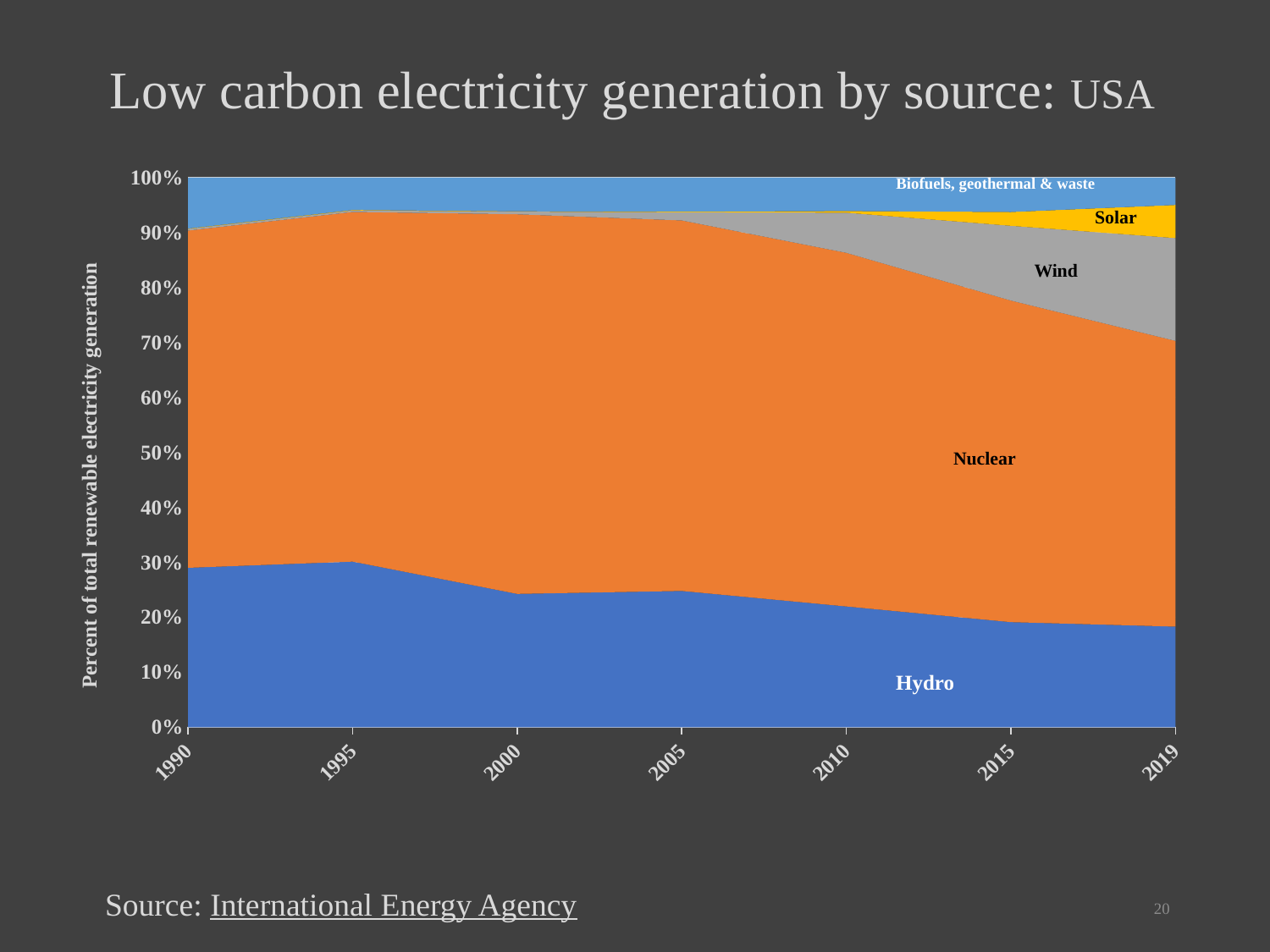
Does the share of Wind rise or fall from 2005 to 2019? Rise How many sources (series) are labelled in the chart? 5 How many years are labelled on the x axis? 7 Which source accounts for the largest share of low carbon electricity generation across the whole period? Nuclear Does the share of Hydro rise or fall from 1990 to 2019? Fall What kind of chart is shown on the slide? Stacked area chart Is the share of Hydro in 2019 greater or less than 25%? less Is the share of Hydro in 1990 greater or less than 20%? greater What is the label on the y axis? Percent of total renewable electricity generation In 2019, which has the larger share: Nuclear or Hydro? Nuclear What is the title of the chart? Low carbon electricity generation by source: USA Is the share of Hydro in 2000 greater or less than 30%? less